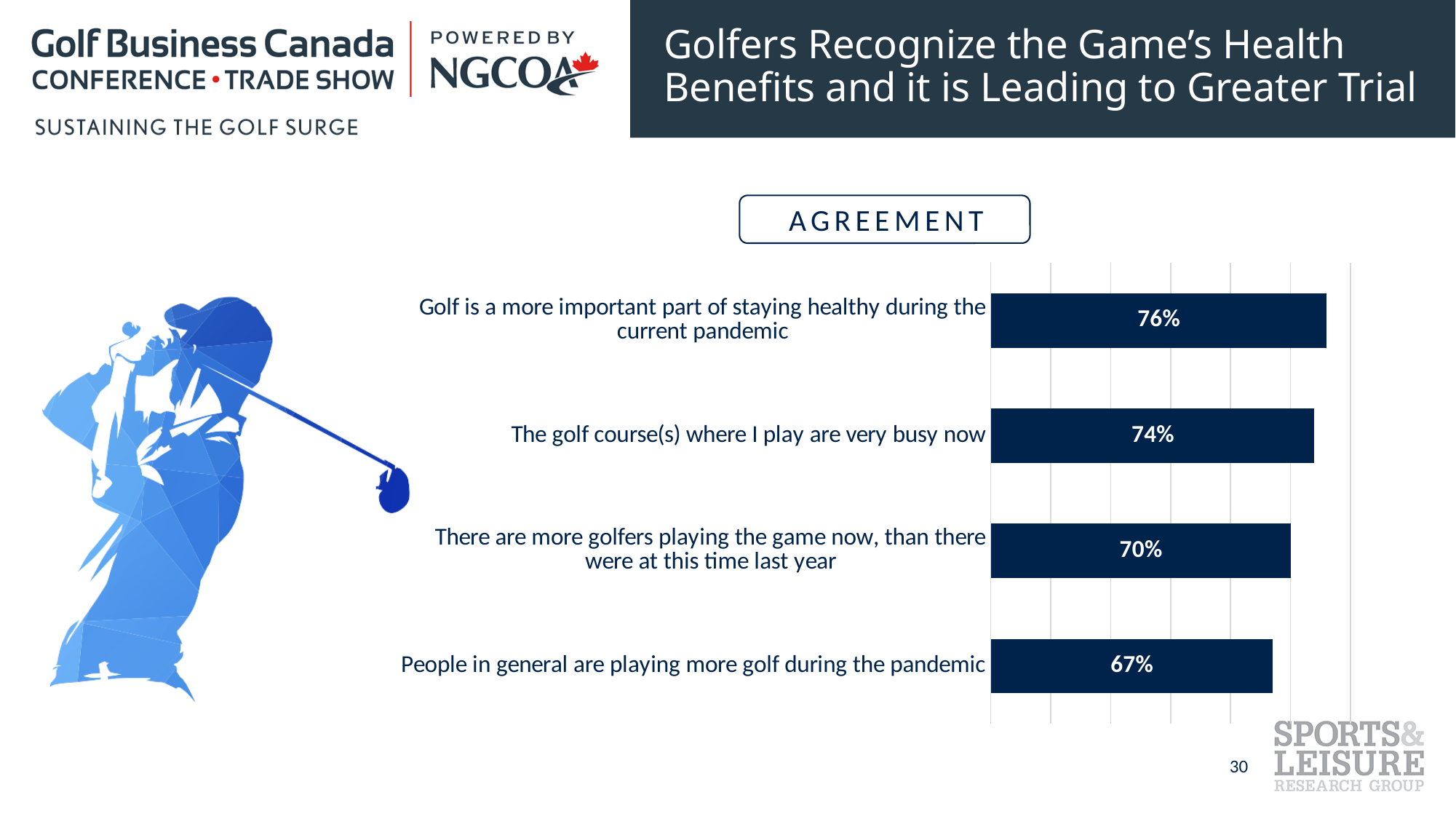
What is the difference between the agreement for 'The golf course(s) where I play are very busy now' and 'There are more golfers playing the game now, than there were at this time last year'? 4% Which has higher agreement: 'The golf course(s) where I play are very busy now' or 'People in general are playing more golf during the pandemic'? The golf course(s) where I play are very busy now How many statements are shown in the chart? 4 What is the label shown in the box above the chart? AGREEMENT What kind of chart is shown on the slide? Bar chart What percentage of golfers agree that golf is a more important part of staying healthy during the current pandemic? 76% Which statement has the lowest level of agreement? People in general are playing more golf during the pandemic What is the difference in agreement between the highest and lowest statements? 9% What percentage agree that there are more golfers playing the game now than at this time last year? 70% What is the agreement value for 'People in general are playing more golf during the pandemic'? 67% Which statement has the highest level of agreement? Golf is a more important part of staying healthy during the current pandemic What is the agreement value for 'The golf course(s) where I play are very busy now'? 74%